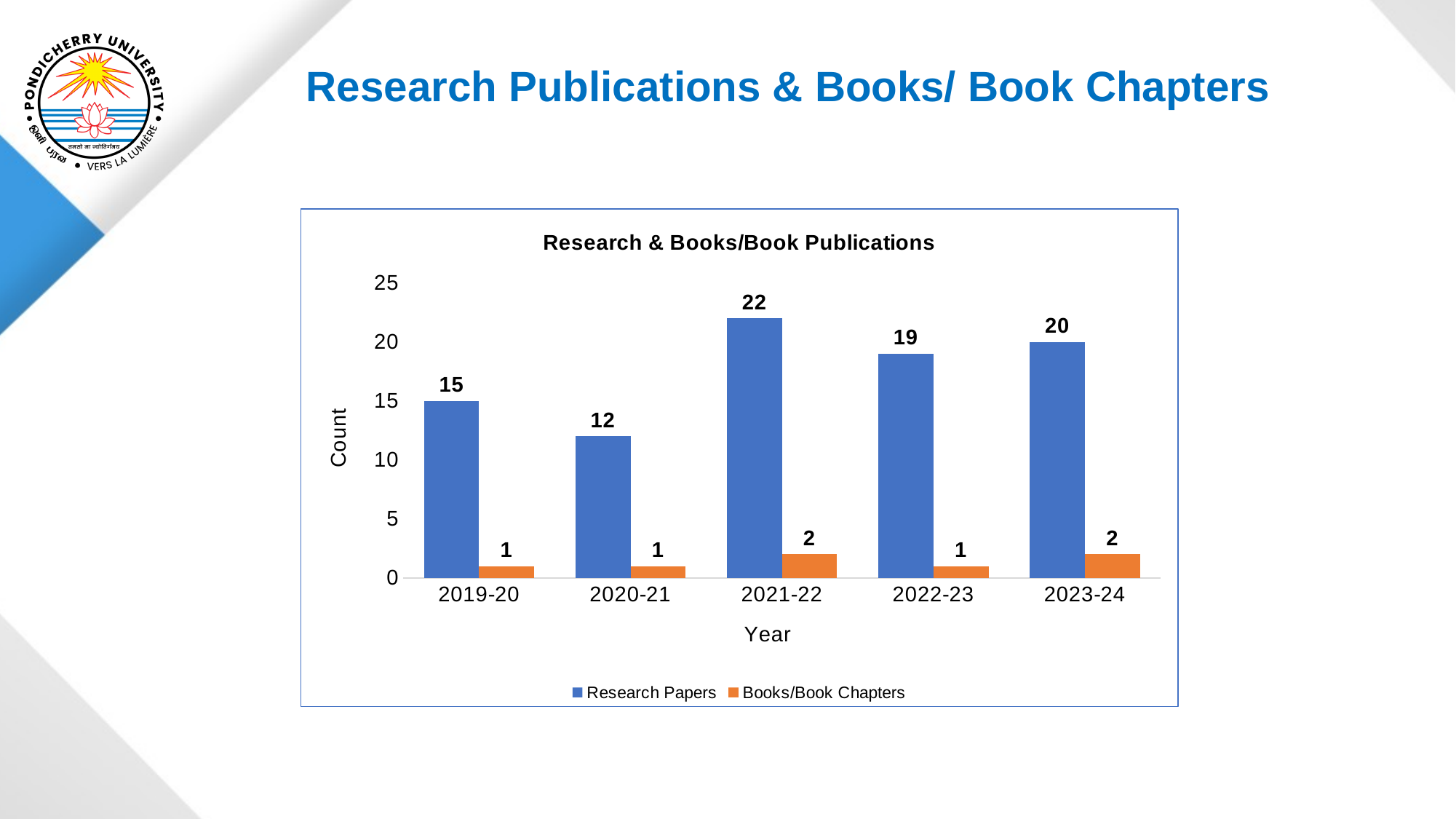
How many Research Papers were published in 2021-22? 22 What is the value for Books/Book Chapters in 2023-24? 2 What is the title of the chart? Research & Books/Book Publications Which year has the lowest number of Research Papers? 2020-21 What is the difference between Research Papers in 2021-22 and 2019-20? 7 Which is larger: Research Papers in 2022-23 or in 2023-24? 2023-24 How many Research Papers were published in 2020-21? 12 How many years are shown on the x axis? 5 How many series does the legend list? 2 Which year has the highest number of Research Papers? 2021-22 Is the value for Research Papers in 2019-20 greater or less than 10? greater What kind of chart is shown on the slide? Bar chart